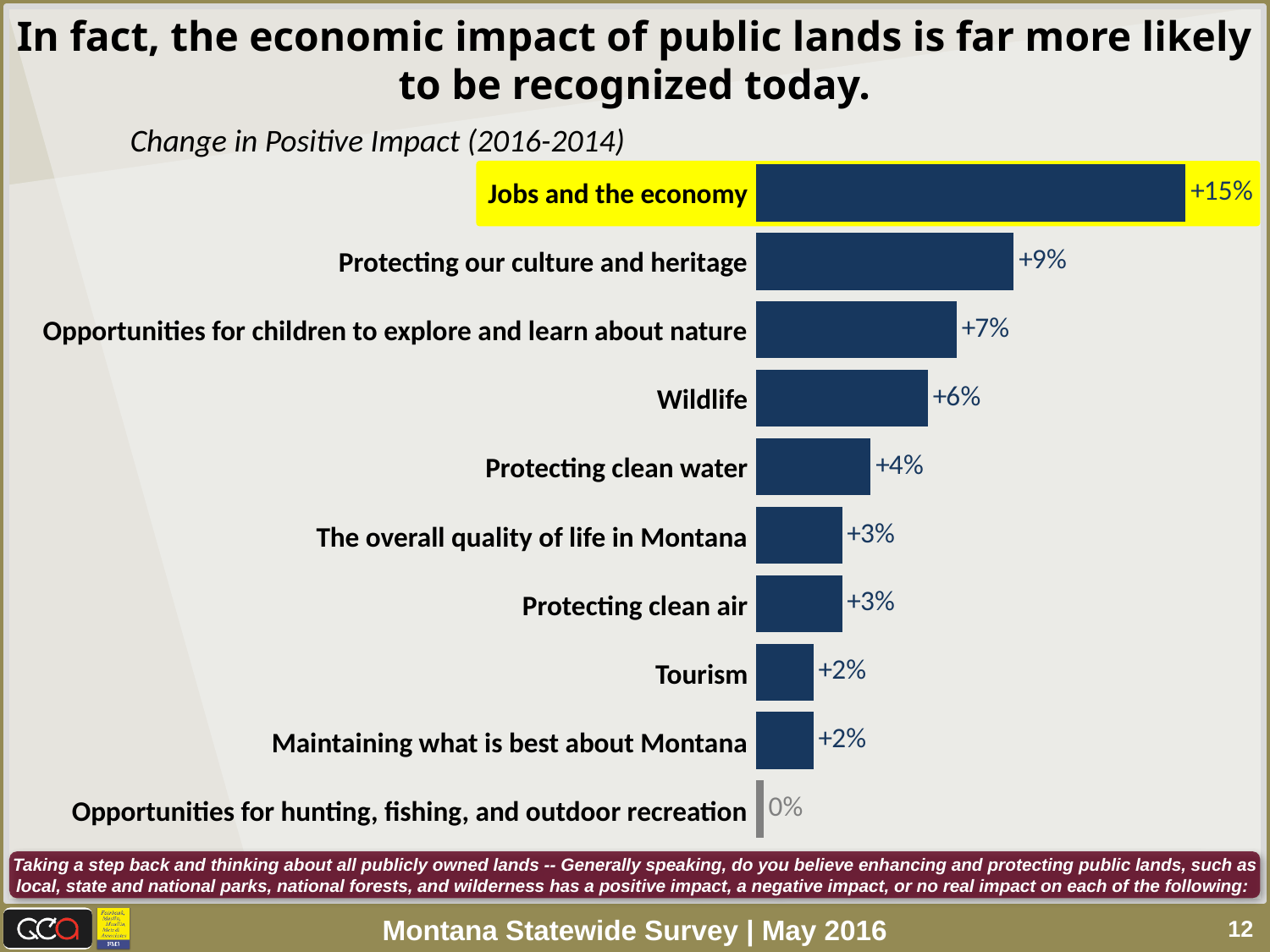
What is the change in positive impact for Wildlife? +6% Which category has the largest change in positive impact? Jobs and the economy What is the title of the chart? Change in Positive Impact (2016-2014) Which category label is highlighted in yellow? Jobs and the economy What is the change in positive impact for Opportunities for hunting, fishing, and outdoor recreation? 0% What is the difference between the change for Jobs and the economy and the change for Protecting our culture and heritage? 6 percentage points Which has a larger change in positive impact: Wildlife or Protecting clean water? Wildlife What kind of chart is shown on the slide? Bar chart What is the change in positive impact for Protecting our culture and heritage? +9% How many categories are shown in the chart? 10 What is the change in positive impact for Jobs and the economy? +15% Which category has the smallest change in positive impact? Opportunities for hunting, fishing, and outdoor recreation